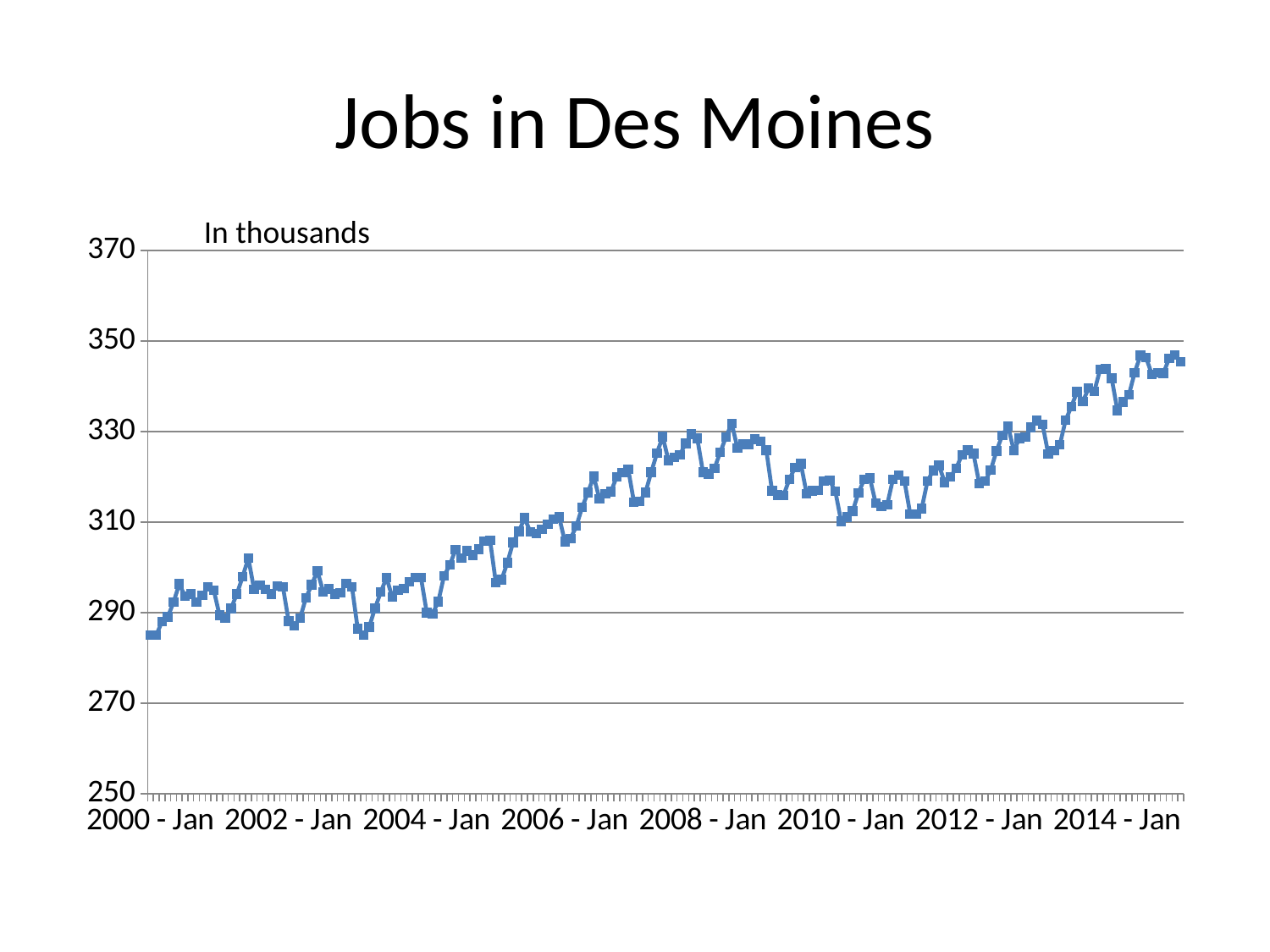
In what units are the values plotted, according to the label above the chart? In thousands What is the title of the chart? Jobs in Des Moines Is the value for 2010 - Jan greater or less than 330? less Which is larger, the value at 2014 - Jan or the value at 2000 - Jan? 2014 - Jan Is the value for 2014 - Jan greater or less than 330? greater Overall, do the values rise or fall from 2000 - Jan to the end of the series? rise Which is larger, the value at 2008 - Jan or the value at 2002 - Jan? 2008 - Jan What kind of chart is shown on the slide? line chart Is the value for 2004 - Jan greater or less than 310? less